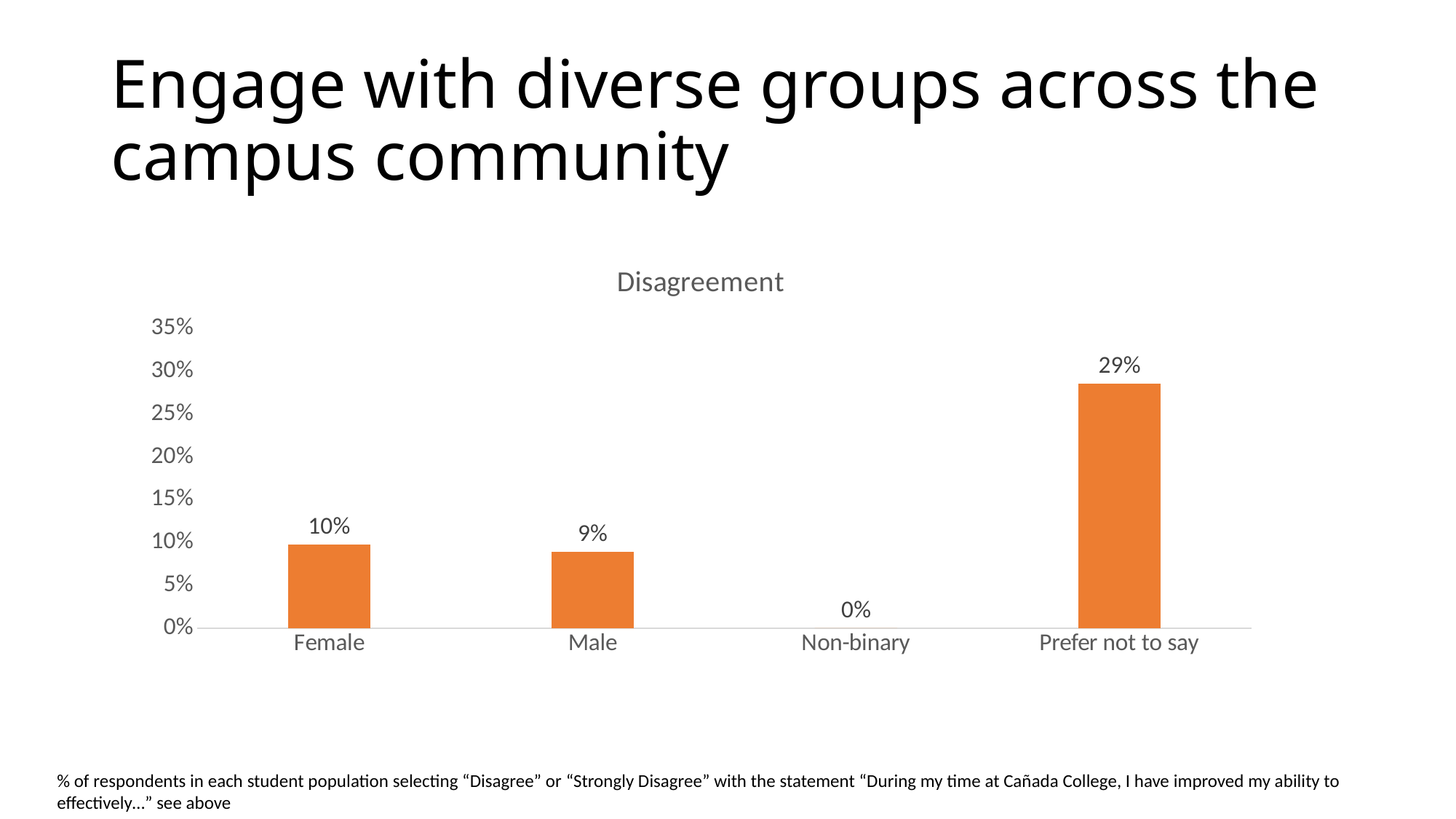
What is the difference between the disagreement values for Prefer not to say and Female? 19% What is the difference between the disagreement values for Female and Male? 1% What is the disagreement value for Male? 9% What is the disagreement value for Non-binary? 0% What is the disagreement value for Prefer not to say? 29% What is the disagreement value for Female? 10% Which category has the highest disagreement value? Prefer not to say What is the title of the chart? Disagreement What kind of chart is shown on the slide? Bar chart Which is larger, the disagreement value for Prefer not to say or for Male? Prefer not to say Which category has the lowest disagreement value? Non-binary How many categories are shown on the x axis of the chart? 4